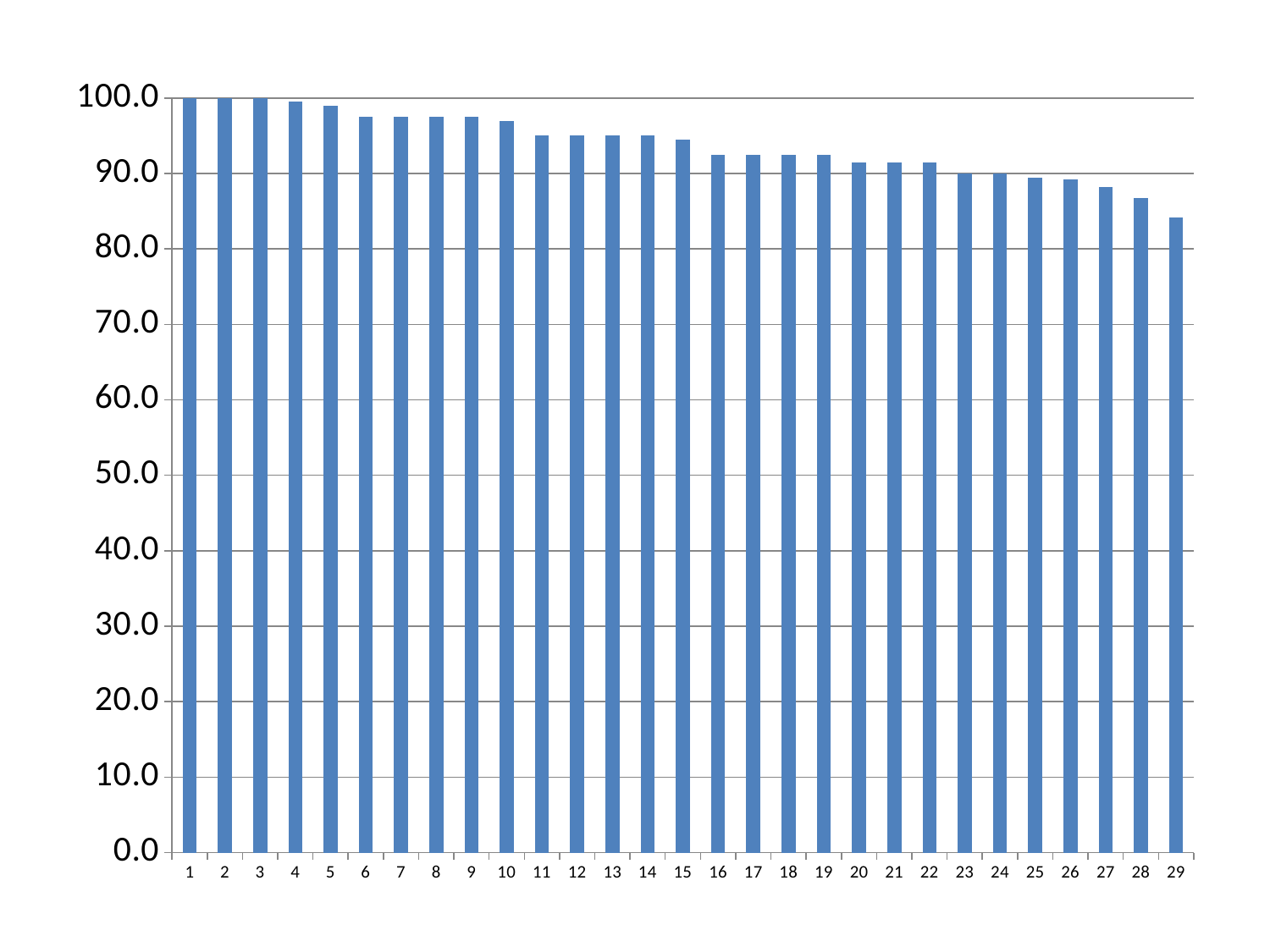
Do the bar values rise or fall as the category number increases from 1 to 29? fall Is the value for category 16 greater or less than 90.0? greater Is the value for category 29 greater or less than 80.0? greater Is the value for category 29 greater or less than 90.0? less How many bars are plotted in the chart? 29 What is the highest value shown on the vertical axis? 100.0 Which category has the lowest bar? 29 Which is larger, the value for category 1 or the value for category 29? category 1 What kind of chart is shown on the slide? bar chart Which is larger, the value for category 10 or the value for category 20? category 10